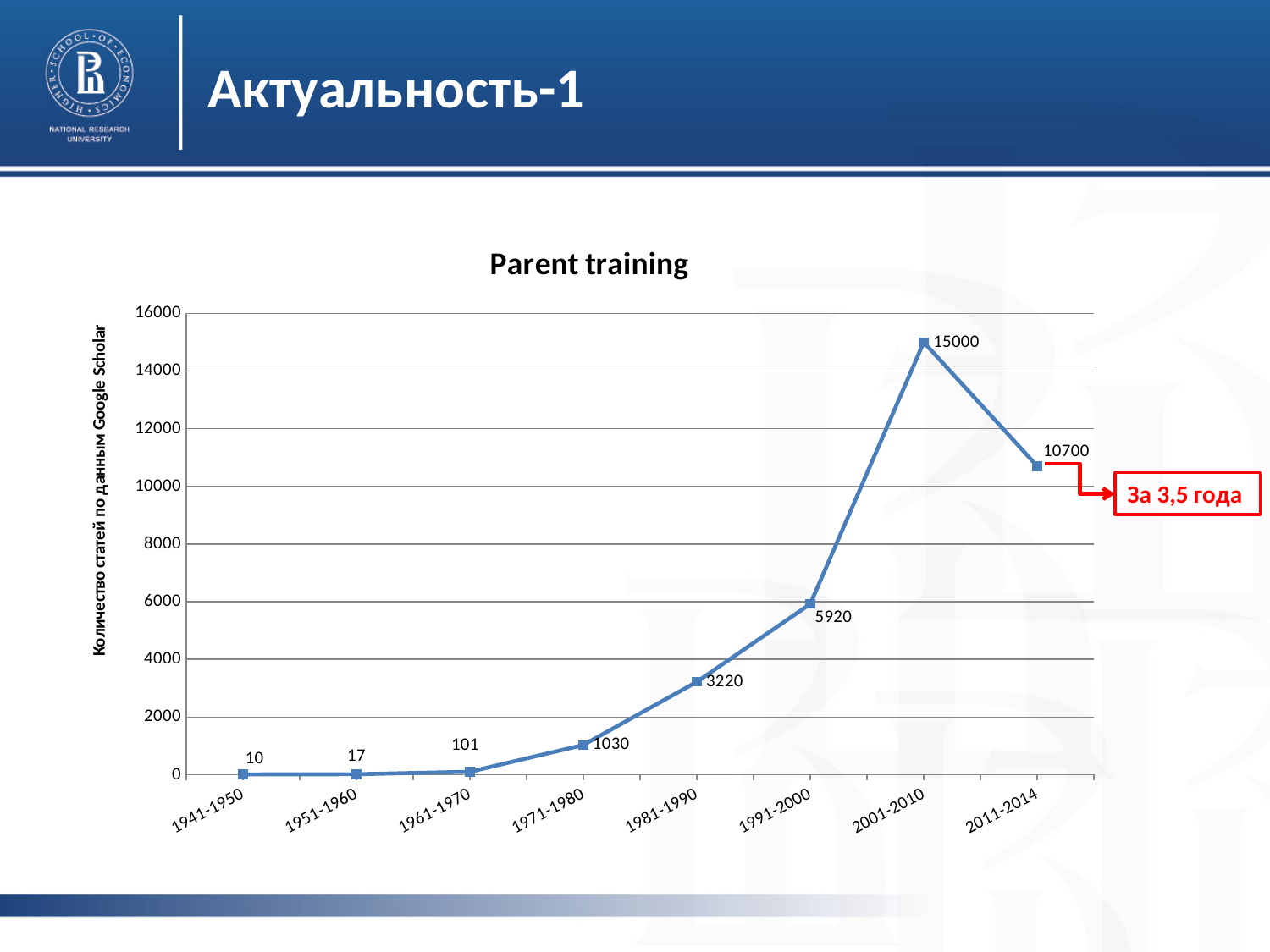
Do the values rise or fall from 1941-1950 to 2001-2010? rise What is the difference between the values for 2001-2010 and 2011-2014? 4300 Which period has the lowest value? 1941-1950 How many periods are shown on the x axis? 8 What kind of chart is shown? line chart What is the title of the chart? Parent training Which period has the highest value? 2001-2010 Which is larger, the value for 1991-2000 or the value for 1981-1990? 1991-2000 What is the value for 2001-2010? 15000 What is the value for 1981-1990? 3220 What is the value for 2011-2014? 10700 Is the value for 1991-2000 greater or less than 4000? greater